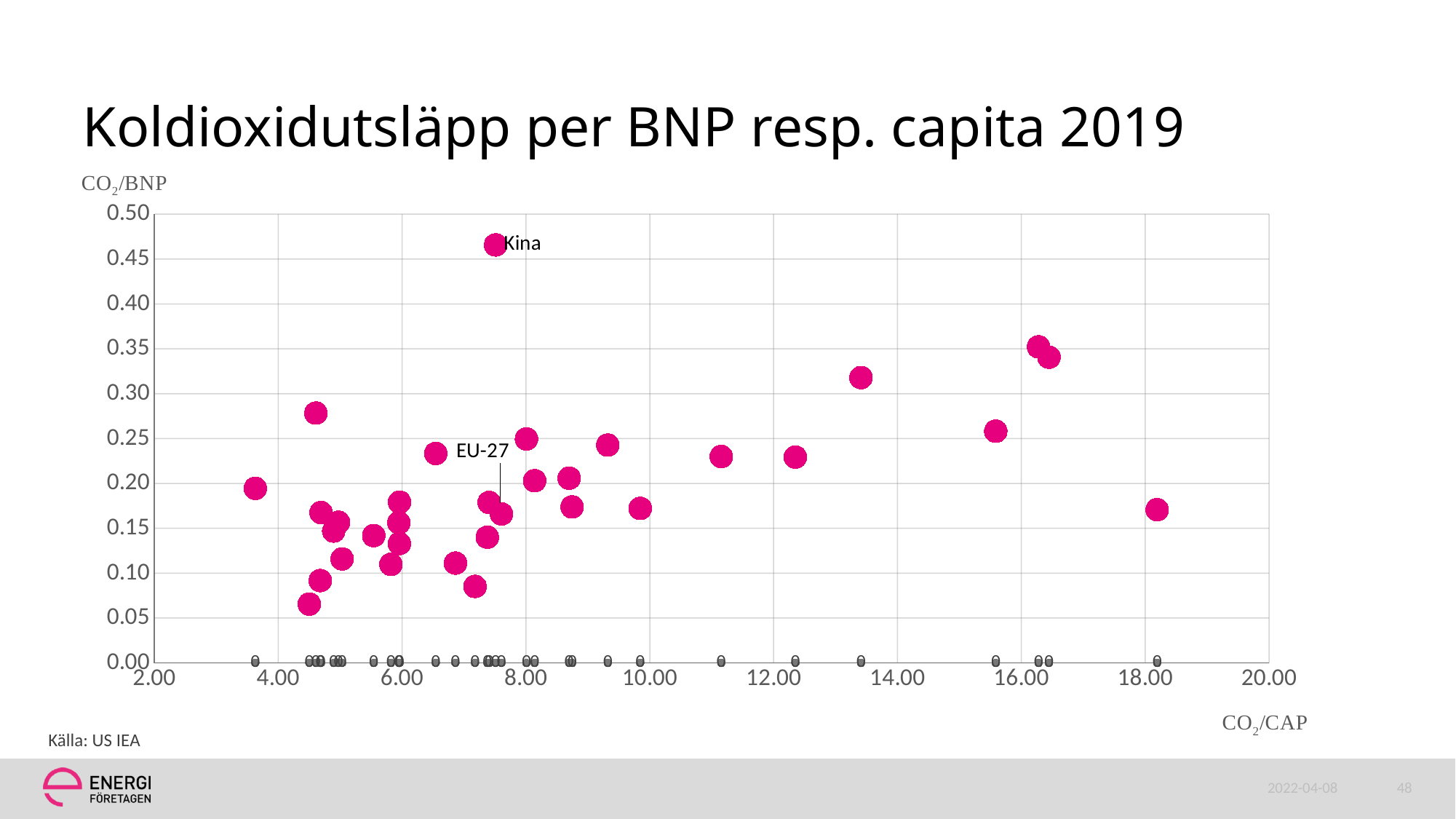
Which of the two labelled points, Kina or EU-27, has the higher CO2/BNP value? Kina What is the title of the chart? Koldioxidutsläpp per BNP resp. capita 2019 What is the label of the horizontal axis? CO2/CAP What kind of chart is shown on the slide? scatter chart Is the CO2/CAP value for EU-27 greater or less than 6.00? greater Is the CO2/BNP value for EU-27 greater or less than 0.20? less Which labelled point has the highest CO2/BNP value in the chart? Kina Is the CO2/BNP value for Kina greater or less than 0.40? greater